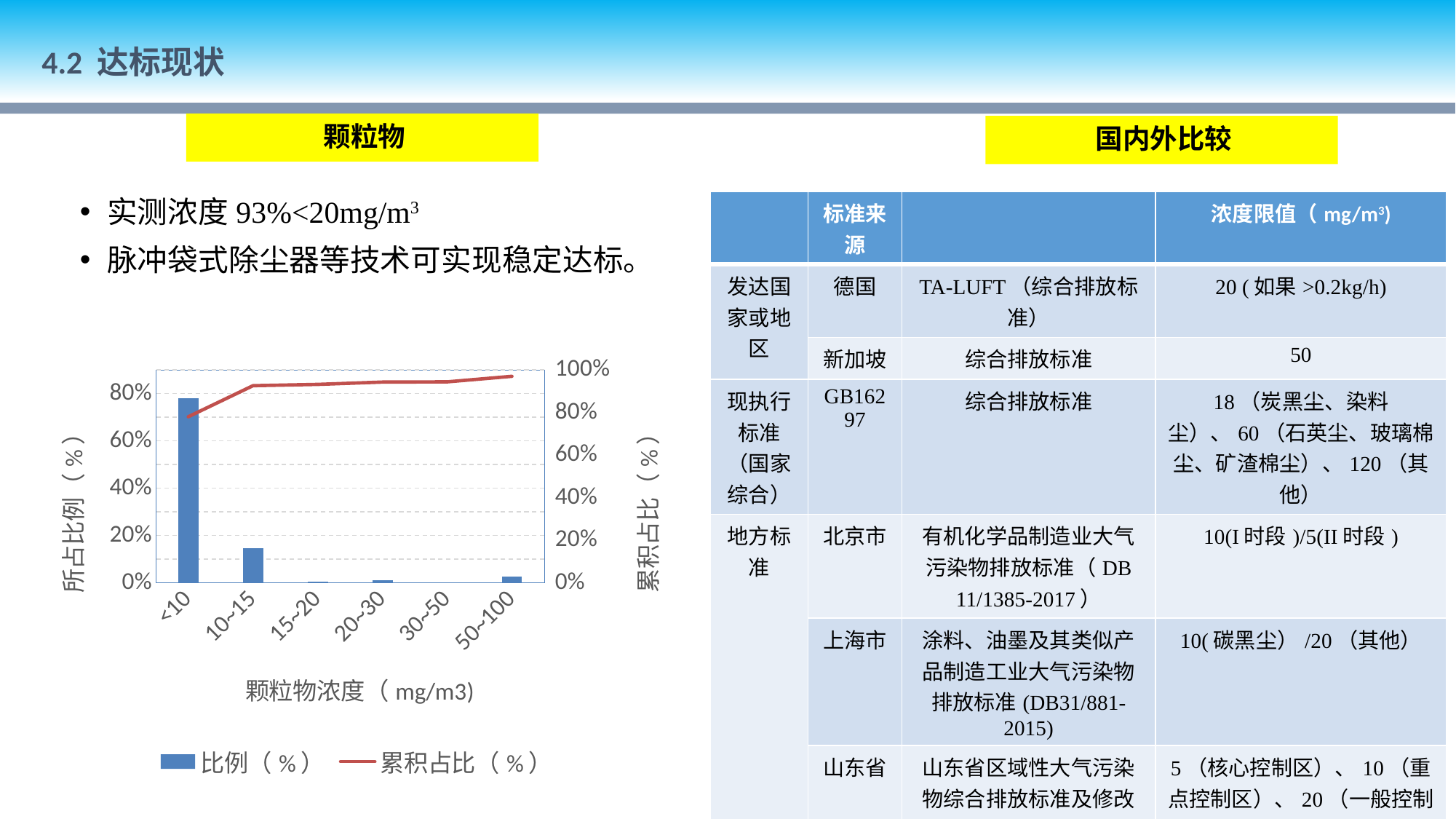
What kind of chart is shown on the slide? A combined bar and line chart Does the 累积占比（%） line rise or fall from <10 to 50~100? rise Is the 比例（%） value for the 10~15 category greater or less than 20%? less Is the 累积占比（%） value for the 10~15 category greater or less than 80%? greater Which concentration category has the highest 比例（%） bar? <10 How many concentration categories are shown on the x axis of the chart? 6 What colour is the 累积占比（%） line in the chart? Red How many series does the chart legend list? 2 Is the 比例（%） value for the 50~100 category greater or less than 20%? less What is the x-axis title of the chart? 颗粒物浓度（mg/m3） Which has the larger 比例（%） bar, <10 or 10~15? <10